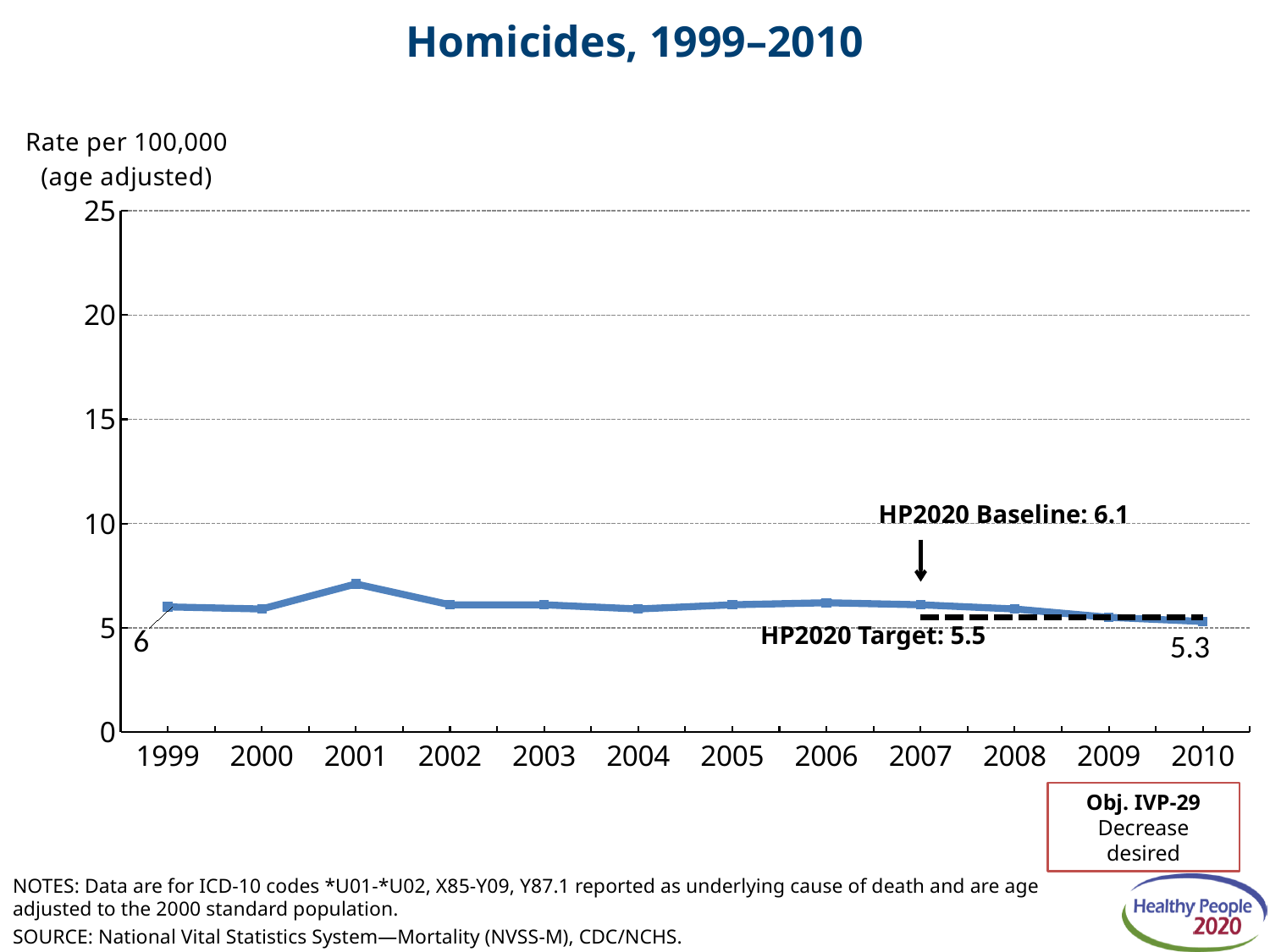
What is the homicide rate per 100,000 shown for 1999? 6 Between 2006 and 2010, does the homicide rate rise or fall? fall What kind of chart is shown on the slide? line chart What is the title of the chart? Homicides, 1999–2010 Is the homicide rate for 2001 greater or less than 10? less By how much did the homicide rate decrease from 1999 to 2010? 0.7 Which year has the higher homicide rate, 2001 or 2004? 2001 What is the homicide rate per 100,000 shown for 2010? 5.3 What is the HP2020 Target value shown on the chart? 5.5 Which year has the highest homicide rate on the chart? 2001 How many years are plotted on the x axis? 12 What is the HP2020 Baseline value shown on the chart? 6.1